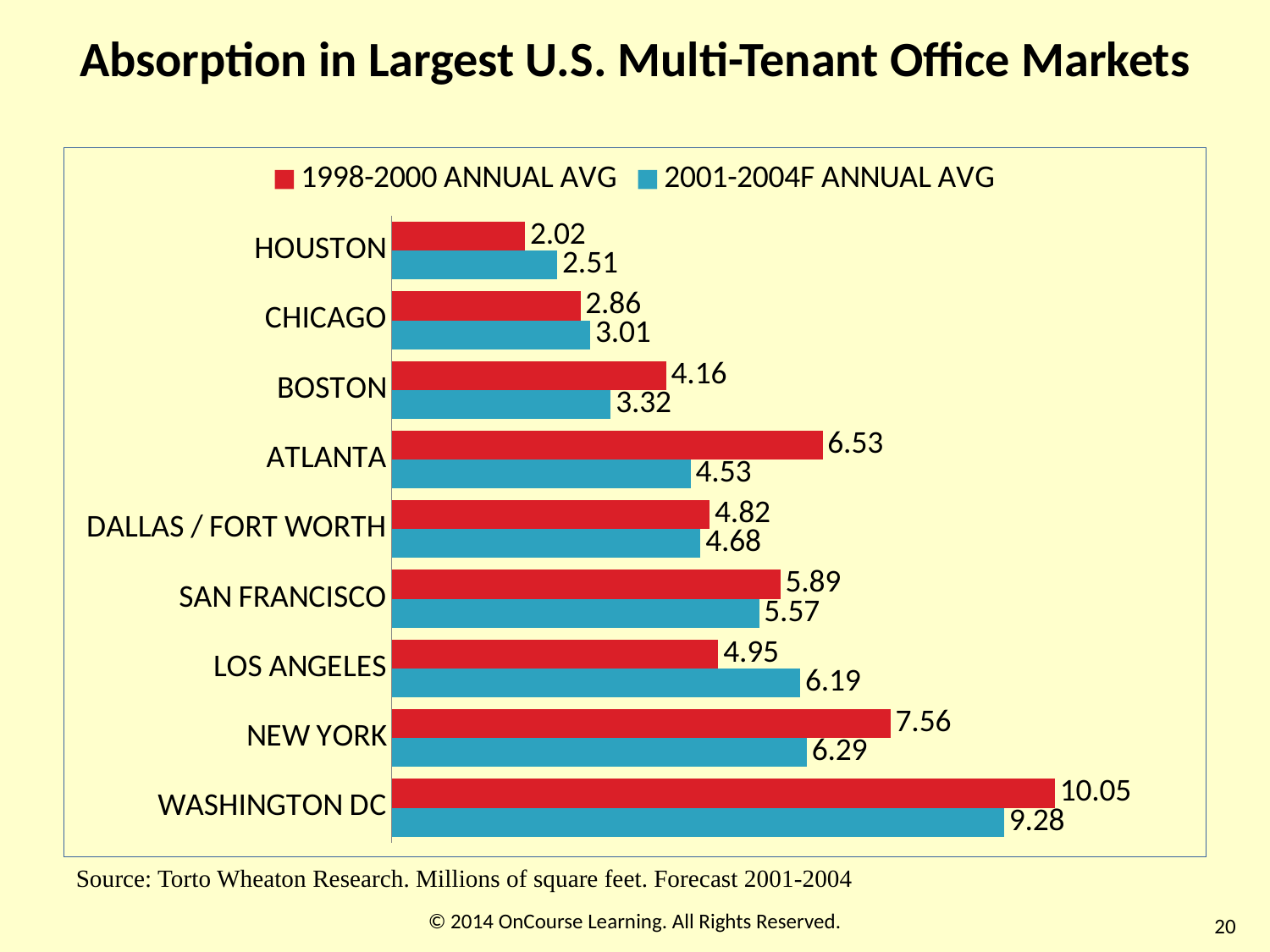
What is the 1998-2000 annual average absorption for Boston? 4.16 Which is larger for Atlanta: the 1998-2000 annual average or the 2001-2004F annual average? 1998-2000 annual average What is the 2001-2004F annual average absorption for Los Angeles? 6.19 How many markets are shown on the chart? 9 What is the 1998-2000 annual average absorption for Washington DC? 10.05 Which market has the highest 2001-2004F annual average absorption? Washington DC Which colour represents the 2001-2004F annual average series? Blue What is the difference between the 1998-2000 annual averages for Washington DC and Houston? 8.03 Which market has the lowest 1998-2000 annual average absorption? Houston How many series does the legend list? 2 What kind of chart is shown on the slide? Bar chart What is the difference between the 1998-2000 and 2001-2004F annual averages for New York? 1.27